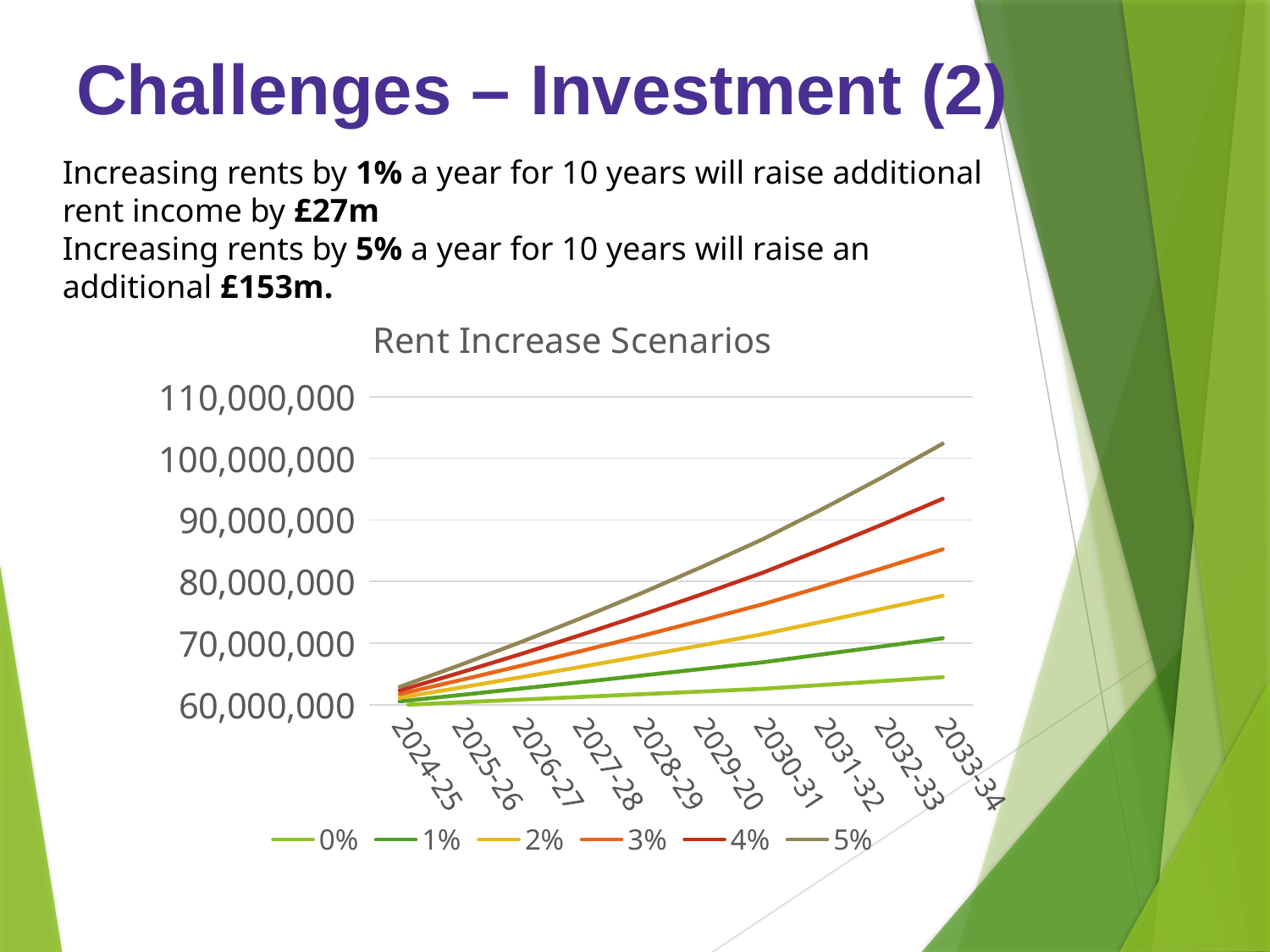
Is the value for the 0% series in 2033-34 greater or less than 70,000,000? less What is the title of the chart? Rent Increase Scenarios Is the value for the 5% series in 2033-34 greater or less than 100,000,000? greater In 2033-34, which series is larger, 4% or 2%? 4% Is the value for the 2% series in 2033-34 greater or less than 80,000,000? less Which series has the lowest value in 2033-34? 0% How many series does the chart legend list? 6 Does the 5% series rise or fall from 2024-25 to 2033-34? rise How many years are shown along the x axis of the chart? 10 What kind of chart is shown on the slide? line chart Which series has the highest value in 2033-34? 5%